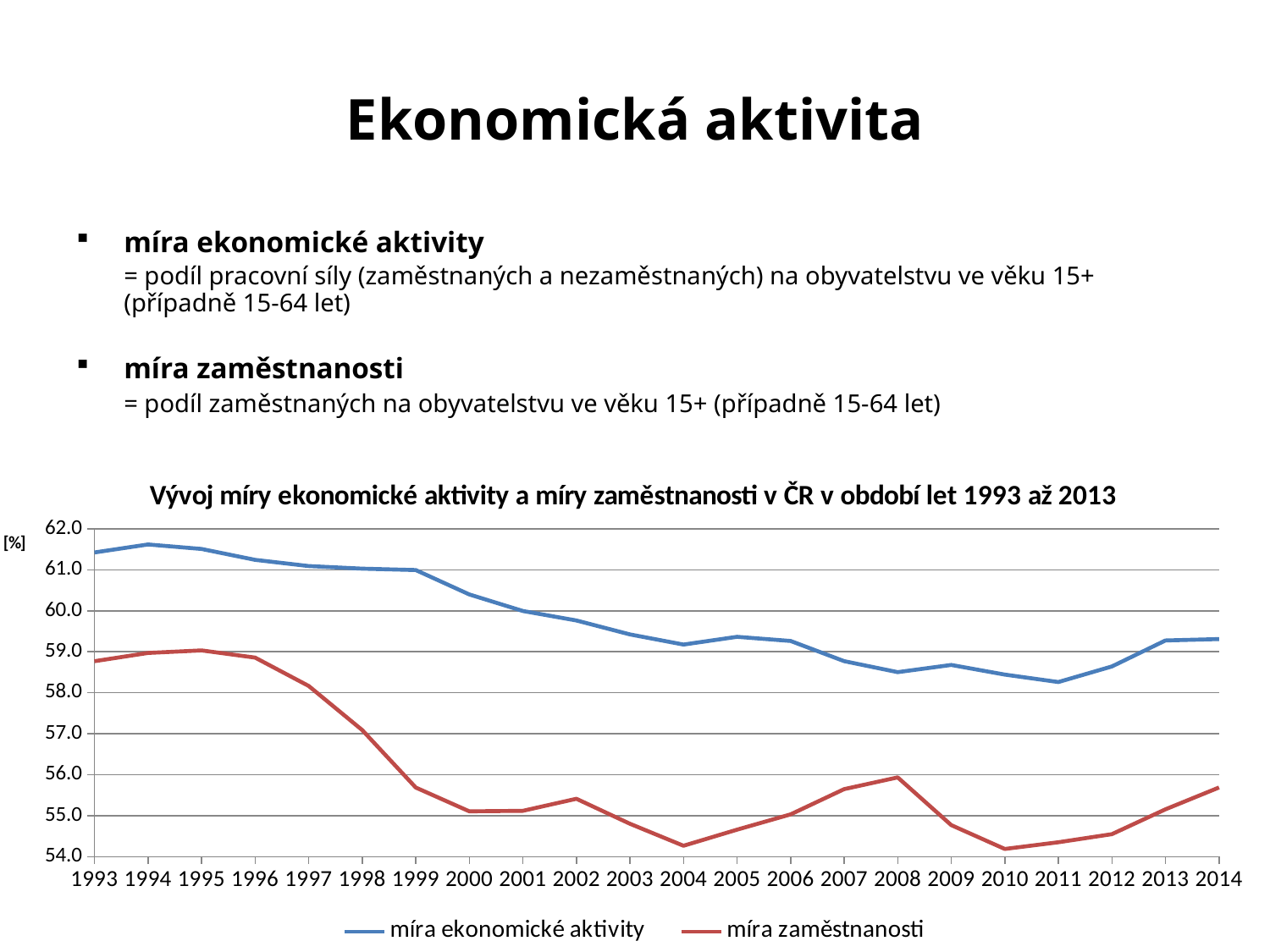
What is the title of the chart? Vývoj míry ekonomické aktivity a míry zaměstnanosti v ČR v období let 1993 až 2013 Is the value of míra zaměstnanosti in 1999 greater or less than 56.0? less How many series does the chart legend list? 2 Is the value of míra ekonomické aktivity in 1993 greater or less than 61.0? greater How many years are plotted along the x axis of the chart? 22 Is the value of míra zaměstnanosti in 2004 greater or less than 55.0? less In which year does míra ekonomické aktivity reach its lowest value? 2011 In 2000, which series has the higher value, míra ekonomické aktivity or míra zaměstnanosti? míra ekonomické aktivity Does míra zaměstnanosti rise or fall between 1995 and 2004? fall What kind of chart is shown on the slide? line chart Which series is drawn in red in the chart? míra zaměstnanosti